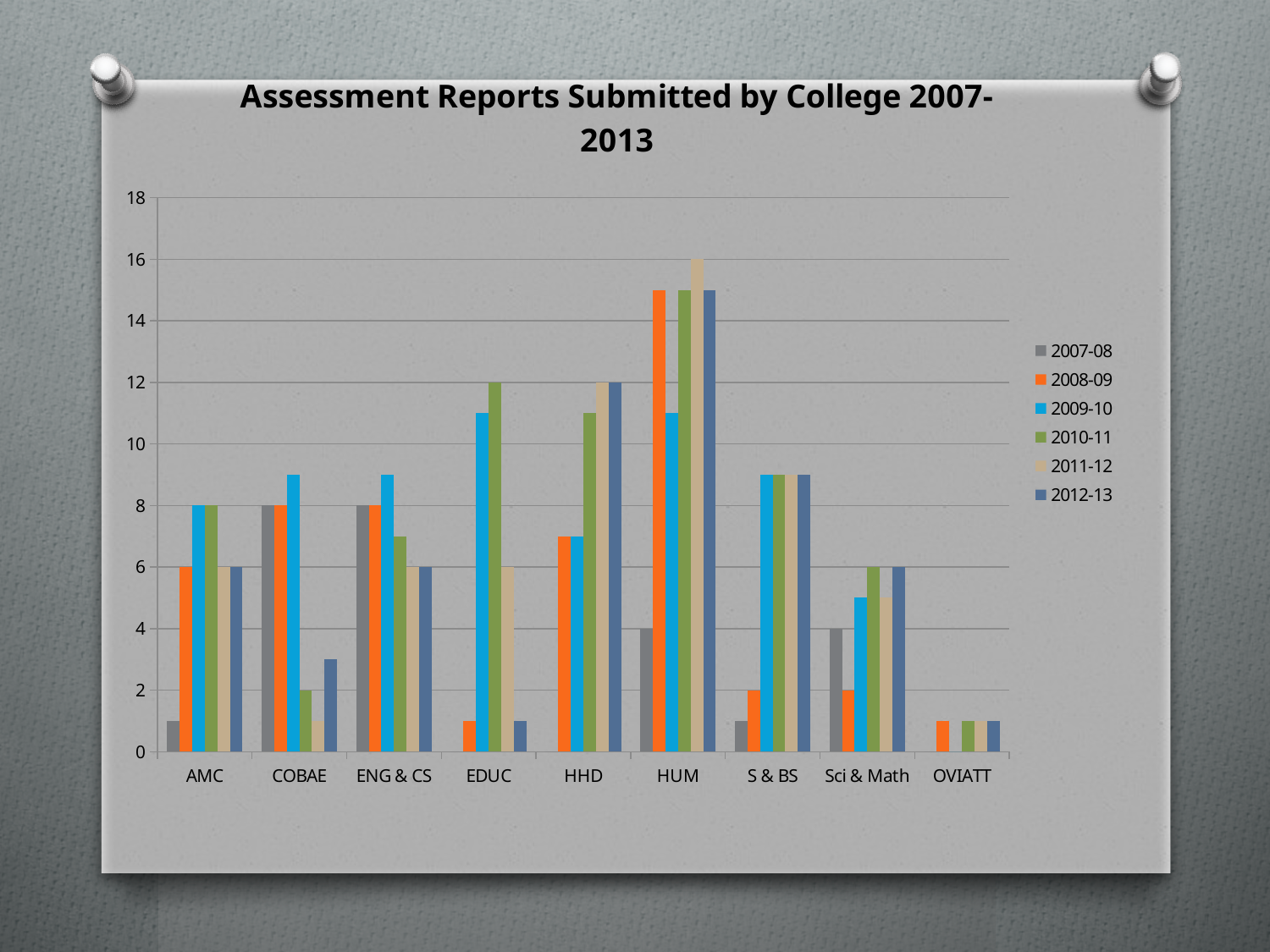
What is the value for HUM in 2011-12? 16 How many colleges are shown on the x axis? 9 What is the value for EDUC in 2010-11? 12 What kind of chart is shown on the slide? bar chart What is the value for HHD in 2012-13? 12 What is the value for Sci & Math in 2007-08? 4 Is the value for COBAE in 2012-13 greater or less than 4? less What is the title of the chart? Assessment Reports Submitted by College 2007-2013 How many series does the legend list? 6 Is the value for HUM in 2008-09 greater or less than 14? greater Which college has the highest value in 2011-12? HUM Which is larger, the 2010-11 value for EDUC or the 2010-11 value for ENG & CS? EDUC